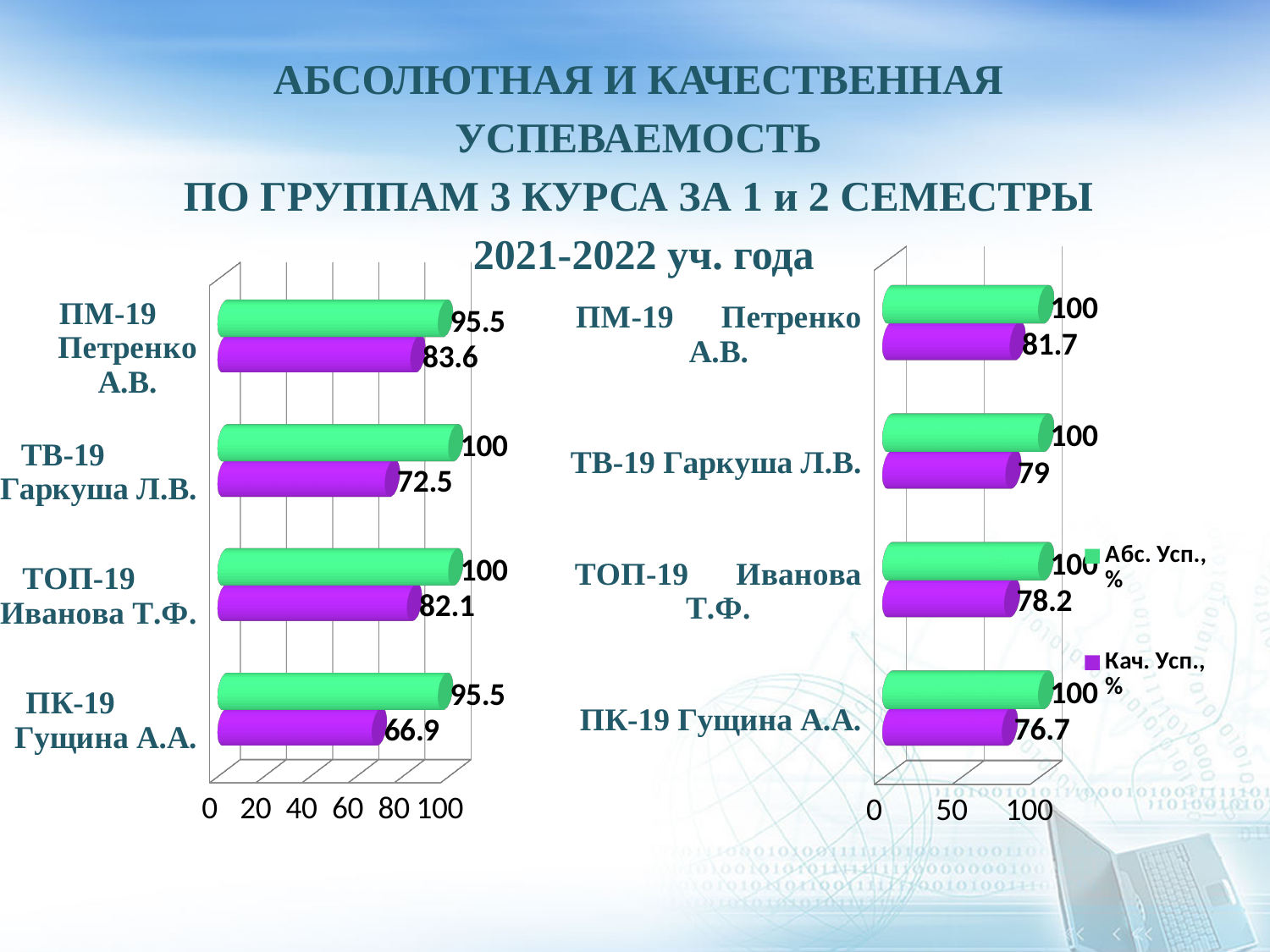
In the left chart, which is larger: the purple value for ТОП-19 Иванова Т.Ф. or the purple value for ТВ-19 Гаркуша Л.В.? ТОП-19 Иванова Т.Ф. What type of chart is the left chart? Bar chart In the left chart, which group has the highest purple (Кач. Усп., %) value? ПМ-19 Петренко А.В. In the left chart, what is the difference between the green and purple bars for ТВ-19 Гаркуша Л.В.? 27.5 How many groups (categories) are shown in the right chart? 4 In the right chart, what is the difference between the purple values for ПМ-19 Петренко А.В. and ПК-19 Гущина А.А.? 5 In the right chart, what is the value of the green (Абс. Усп., %) bar for ТОП-19 Иванова Т.Ф.? 100 In the left chart, what is the value of the green (Абс. Усп., %) bar for ПМ-19 Петренко А.В.? 95.5 In the left chart, what is the value of the purple (Кач. Усп., %) bar for ПК-19 Гущина А.А.? 66.9 In the right chart, which group has the lowest purple (Кач. Усп., %) value? ПК-19 Гущина А.А. In the right chart, what is the value of the purple (Кач. Усп., %) bar for ТВ-19 Гаркуша Л.В.? 79 How many series does the legend of the right chart list? 2